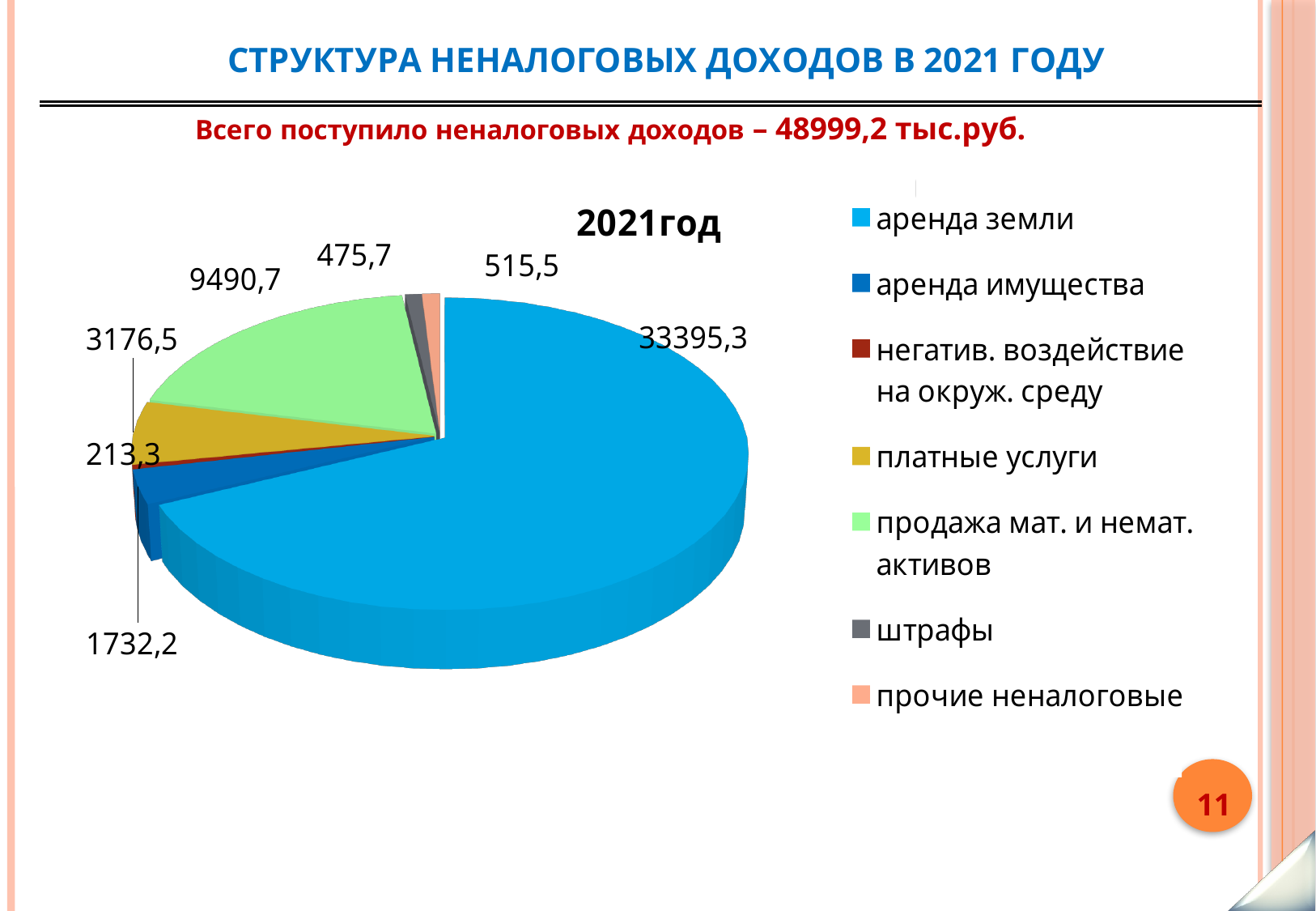
Which category has the smallest slice of the pie? негатив. воздействие на окруж. среду What is the value for аренда имущества? 1732,2 Which category has the largest slice of the pie? аренда земли What is the value for платные услуги? 3176,5 What type of chart is shown on the slide? pie chart What is the value for аренда земли in the 2021год pie chart? 33395,3 What is the difference between продажа мат. и немат. активов and платные услуги? 6314,2 What is the value for продажа мат. и немат. активов? 9490,7 What is the title of the pie chart? 2021год Which is larger, штрафы or прочие неналоговые? прочие неналоговые What is the value for негатив. воздействие на окруж. среду? 213,3 How many categories does the pie chart have? 7